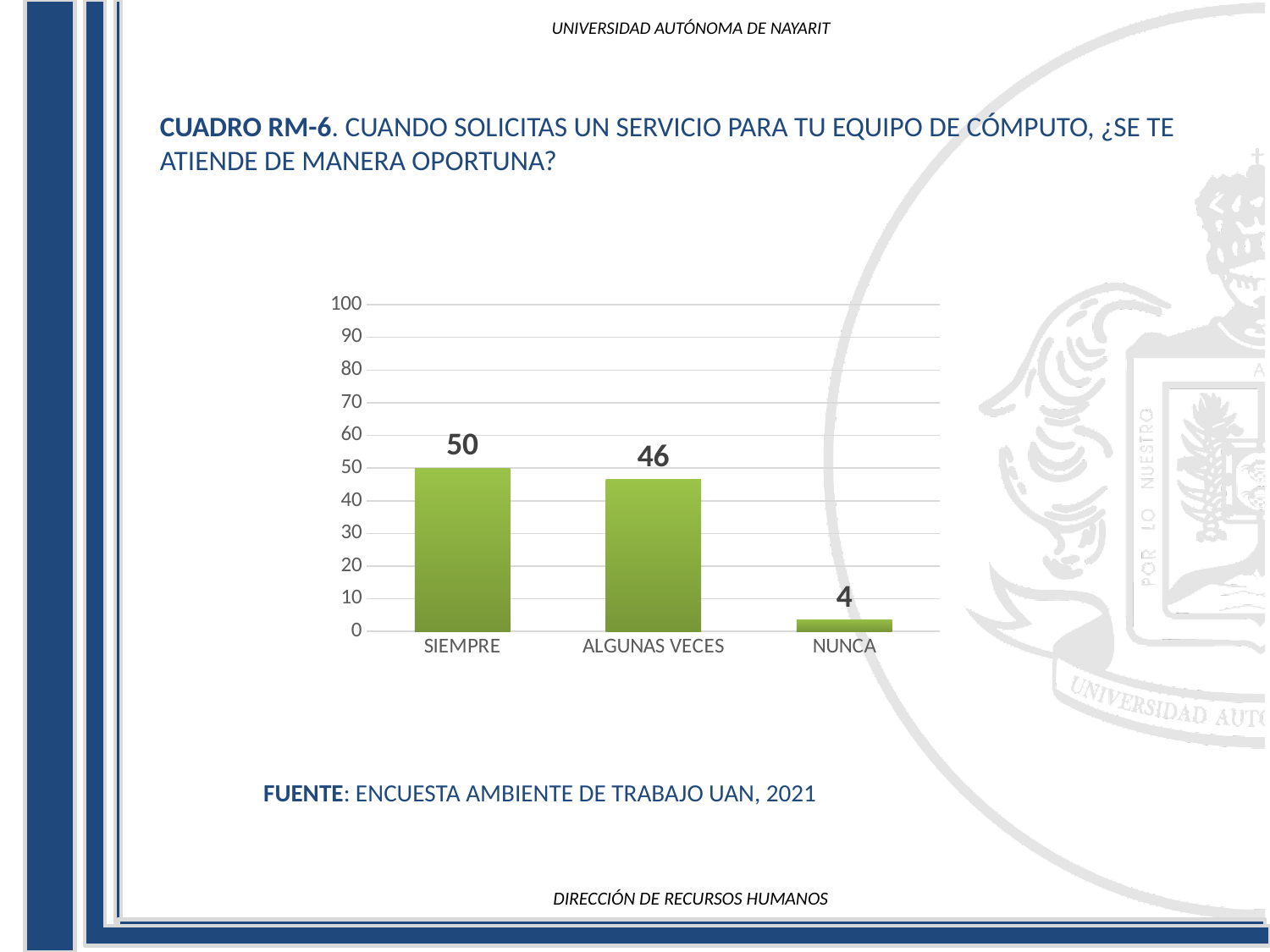
What is the difference between the values for SIEMPRE and ALGUNAS VECES? 4 Which category has the highest value? SIEMPRE What is the value for SIEMPRE? 50 What is the value for NUNCA? 4 Is the value for NUNCA greater or less than 10? less Which category has the lowest value? NUNCA How many categories are shown on the x axis? 3 Which is larger, the value for ALGUNAS VECES or the value for NUNCA? ALGUNAS VECES What is the source cited below the chart? ENCUESTA AMBIENTE DE TRABAJO UAN, 2021 What kind of chart is shown on the slide? bar chart What is the difference between the values for ALGUNAS VECES and NUNCA? 42 What is the value for ALGUNAS VECES? 46